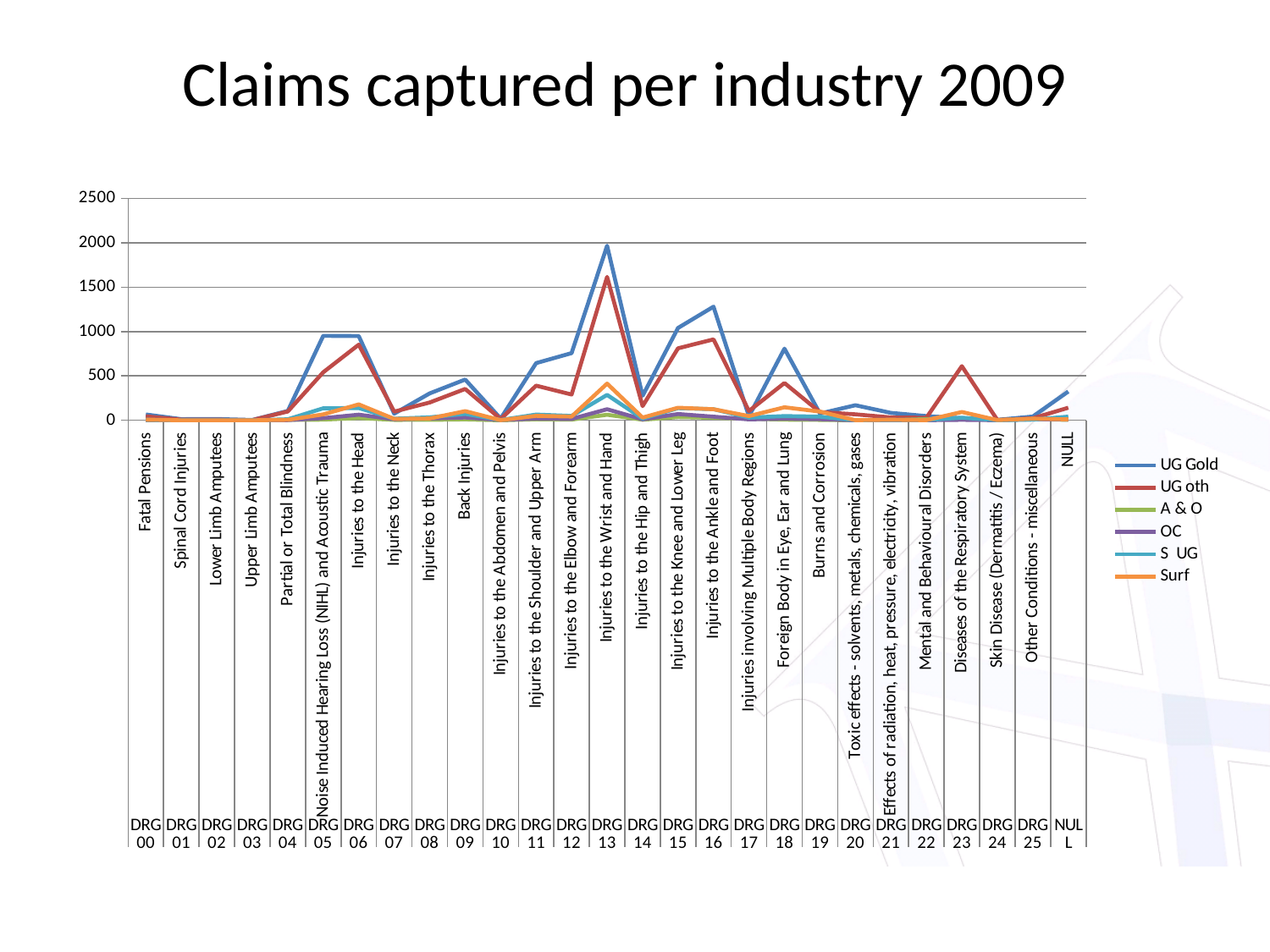
What kind of chart is shown on the slide? line chart For which category does the UG oth series reach its highest value? Injuries to the Wrist and Hand How many series does the legend list? 6 Is the UG oth value for Injuries to the Wrist and Hand greater or less than 1000? greater Which series has the larger value for Diseases of the Respiratory System, UG Gold or UG oth? UG oth How many categories are plotted along the x axis? 27 Is the UG Gold value for Injuries to the Ankle and Foot greater or less than 1000? greater Which series has the larger value for Injuries to the Wrist and Hand, UG Gold or UG oth? UG Gold Is the UG Gold value for Foreign Body in Eye, Ear and Lung greater or less than 500? greater For which category does the UG Gold series reach its highest value? Injuries to the Wrist and Hand What is the title of the chart? Claims captured per industry 2009